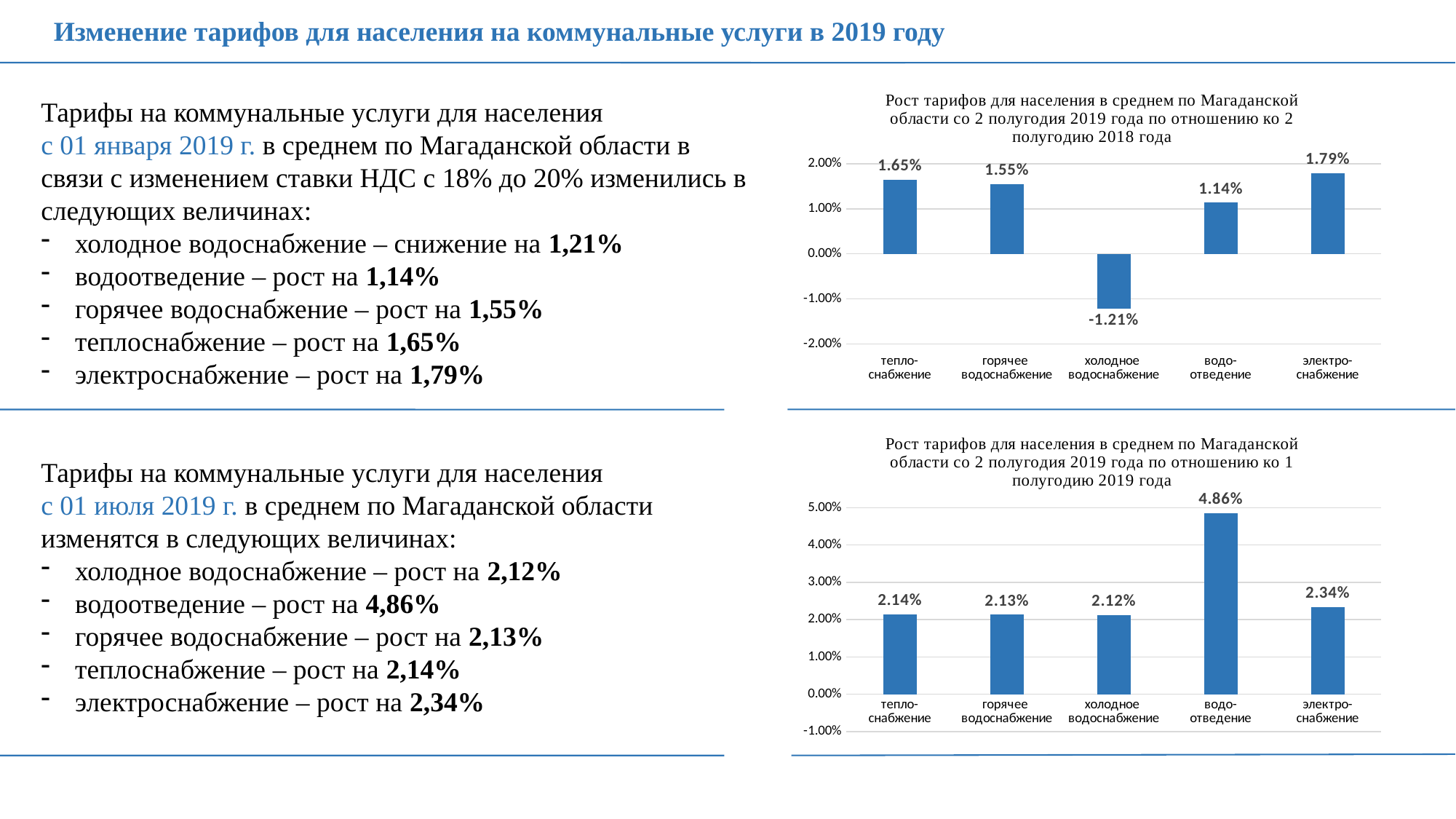
In the bottom chart, which category has the highest value? водоотведение In the bottom chart, what is the difference between the values for водоотведение and холодное водоснабжение? 2.74% In the top chart, which category has the lowest value? холодное водоснабжение In the top chart, how many categories are shown? 5 What type of chart is the top chart? bar chart In the top chart, which category has the highest value? электроснабжение In the bottom chart, what is the value for электроснабжение? 2.34% In the top chart, what is the difference between the values for электроснабжение and водоотведение? 0.65% In the bottom chart, what is the value for водоотведение? 4.86% In the bottom chart, which is larger: the value for электроснабжение or the value for теплоснабжение? электроснабжение In the top chart, what is the value for холодное водоснабжение? -1.21% In the top chart, is the value for теплоснабжение greater or less than 1.00%? greater